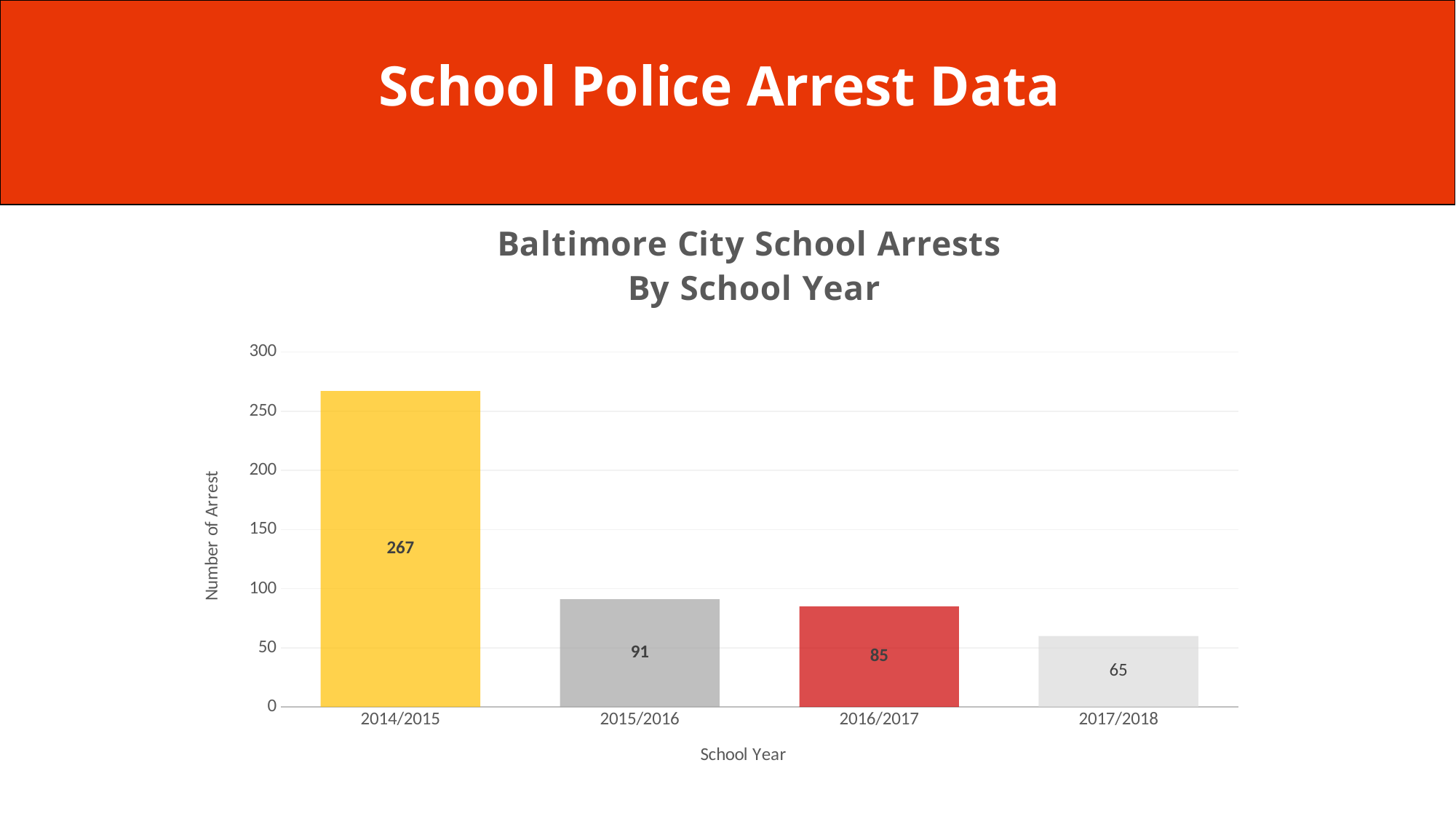
Which school year has the highest number of arrests? 2014/2015 What is the title of the chart? Baltimore City School Arrests By School Year Which school year had more arrests, 2015/2016 or 2016/2017? 2015/2016 Which school year has the lowest number of arrests? 2017/2018 How many school years are shown in the chart? 4 What kind of chart is shown on the slide? Bar chart What is the number of arrests for the 2014/2015 school year? 267 What is the number of arrests for the 2016/2017 school year? 85 What is the number of arrests for the 2017/2018 school year? 65 What is the difference in arrests between 2014/2015 and 2015/2016? 176 Do the number of arrests rise or fall from 2014/2015 to 2017/2018? Fall What is the difference in arrests between 2016/2017 and 2017/2018? 20